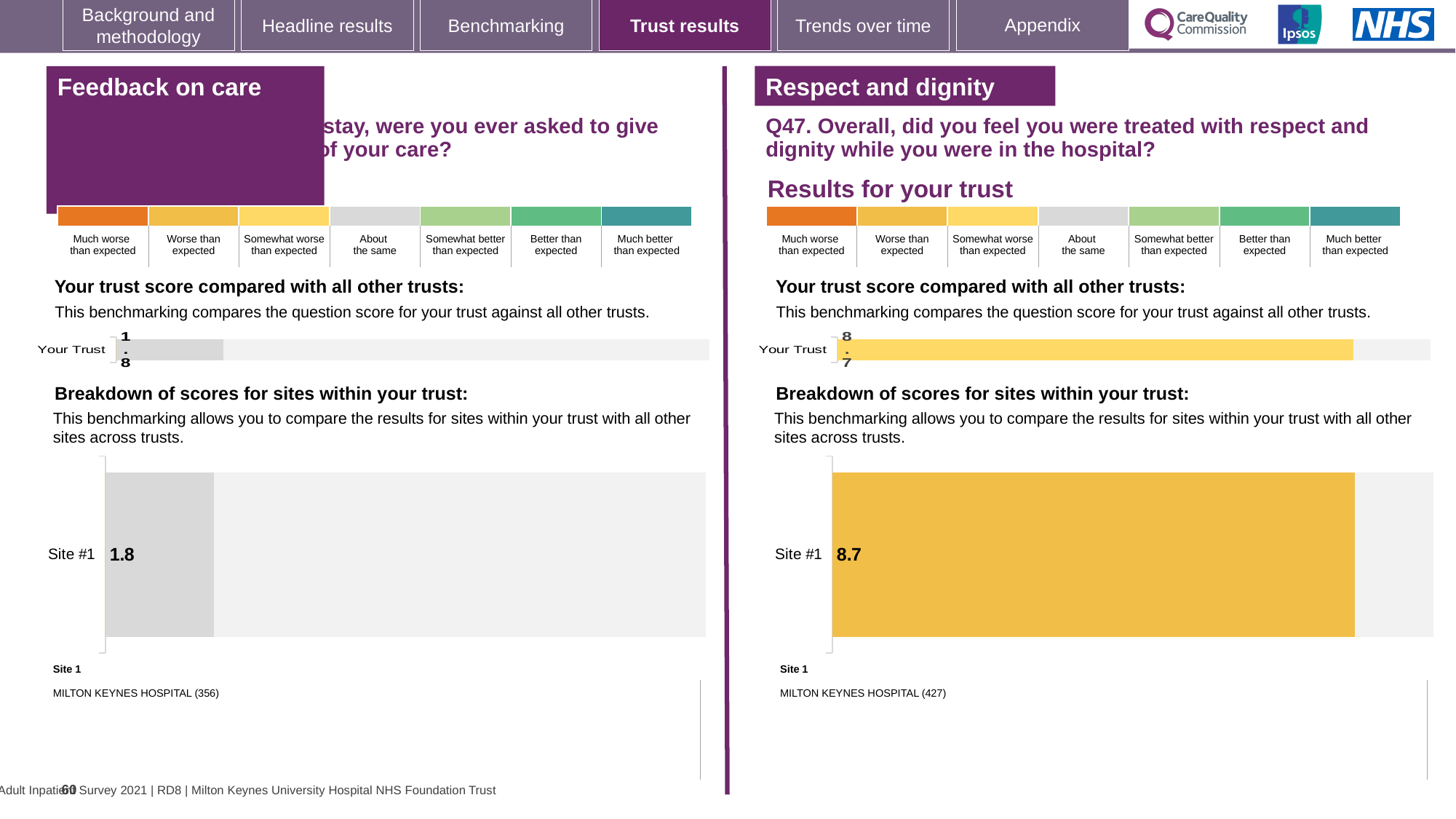
On the Feedback on care section (left), what is the score shown for Site #1 in the breakdown of scores for sites chart? 1.8 What is the difference between the Site #1 score in the Respect and dignity section (right) and the Site #1 score in the Feedback on care section (left)? 6.9 On the Respect and dignity section (right), what is the score shown for Your Trust in the trust score chart? 8.7 In the Feedback on care section (left), what colour is the Site #1 bar? Grey What kind of chart is used to show the Site #1 score in the Feedback on care section (left)? Bar chart On the Feedback on care section (left), what is the score shown for Your Trust in the trust score chart? 1.8 How many sites are shown in the breakdown of scores chart in the Respect and dignity section (right)? 1 In the Respect and dignity section (right), which site name is listed for Site 1 below the chart? MILTON KEYNES HOSPITAL (427) How many sites are shown in the breakdown of scores chart in the Feedback on care section (left)? 1 Which Site #1 score is larger: the one in the Feedback on care section (left) or the one in the Respect and dignity section (right)? Respect and dignity (right) On the Respect and dignity section (right), what is the score shown for Site #1 in the breakdown of scores for sites chart? 8.7